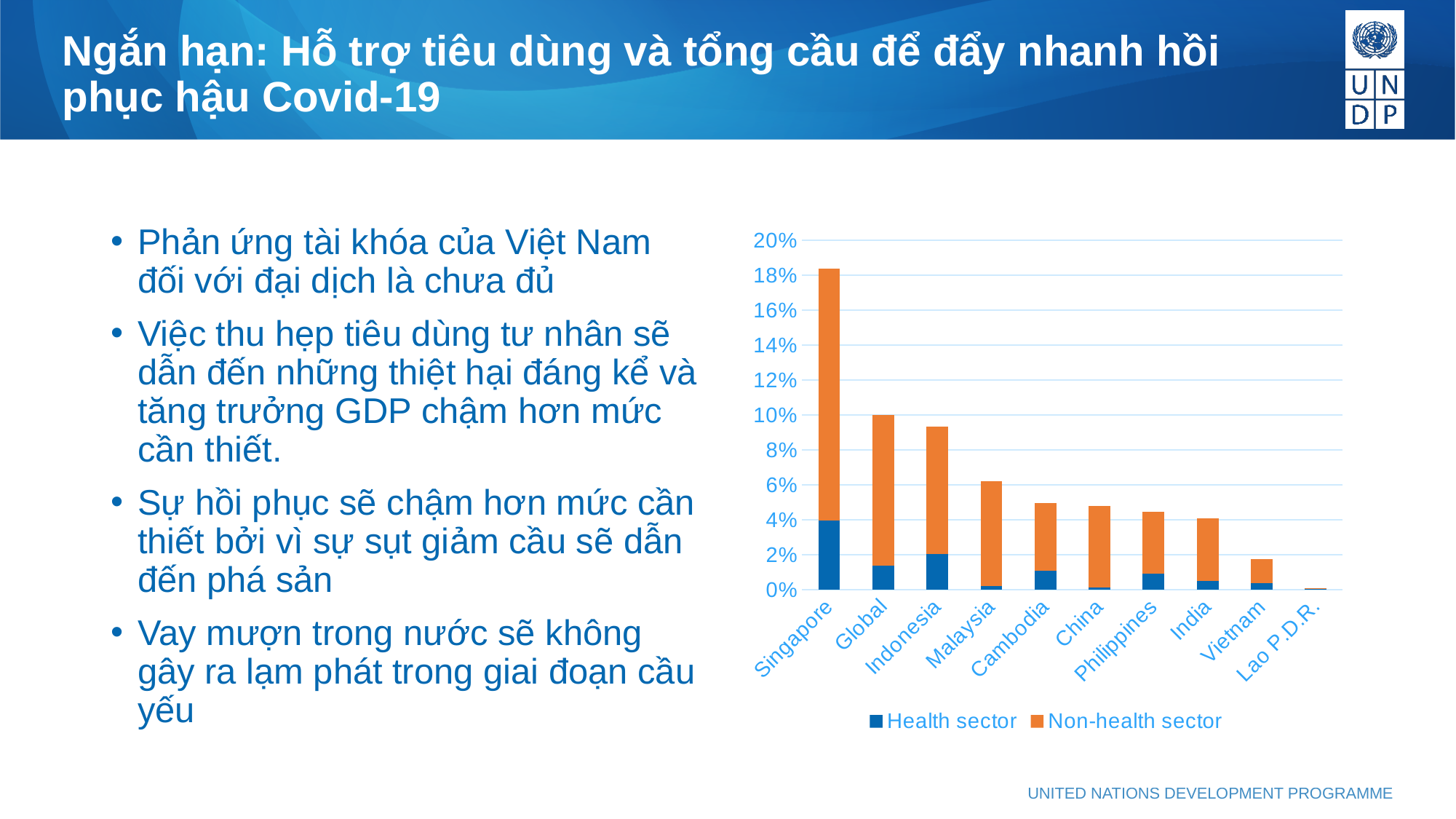
Which colour represents the Health sector series in the chart? Blue Which category has the lowest total bar in the chart? Lao P.D.R. How many countries or categories are shown on the x axis of the chart? 10 Which category has the highest total bar in the chart? Singapore Do the total bar values rise or fall moving from left to right along the x axis? Fall How many series does the chart's legend list? 2 Is the total value for Indonesia greater or less than 10%? less Is the total value for Singapore greater or less than 18%? greater What kind of chart is shown on the slide? Stacked bar chart Which has a larger total bar, Indonesia or Malaysia? Indonesia